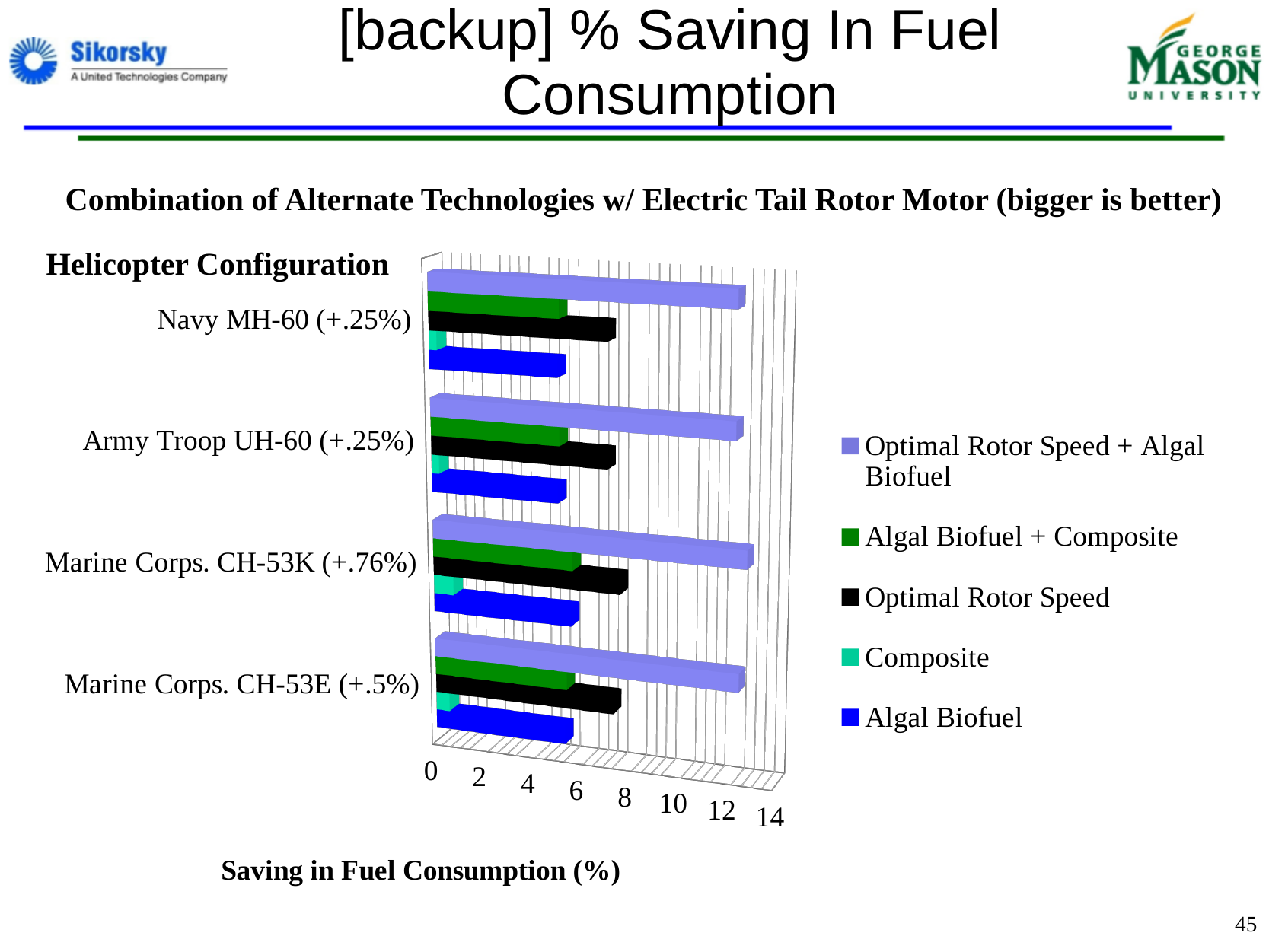
For Marine Corps. CH-53E (+.5%), which is larger: the Algal Biofuel bar or the Composite bar? Algal Biofuel For Navy MH-60 (+.25%), which series has the highest saving in fuel consumption? Optimal Rotor Speed + Algal Biofuel For Marine Corps. CH-53K (+.76%), which series has the lowest saving in fuel consumption? Composite What is the title of the horizontal axis of the chart? Saving in Fuel Consumption (%) How many series does the chart legend list? 5 How many helicopter configurations are plotted on the chart? 4 Is the Optimal Rotor Speed + Algal Biofuel value for Navy MH-60 (+.25%) greater or less than 8? greater Is the Composite value for Army Troop UH-60 (+.25%) greater or less than 2? less What is the title shown above the chart? Combination of Alternate Technologies w/ Electric Tail Rotor Motor (bigger is better) Is the Optimal Rotor Speed value for Marine Corps. CH-53K (+.76%) greater or less than 4? greater What kind of chart is shown on the slide? bar chart For Army Troop UH-60 (+.25%), which is larger: the Optimal Rotor Speed bar or the Algal Biofuel + Composite bar? Optimal Rotor Speed